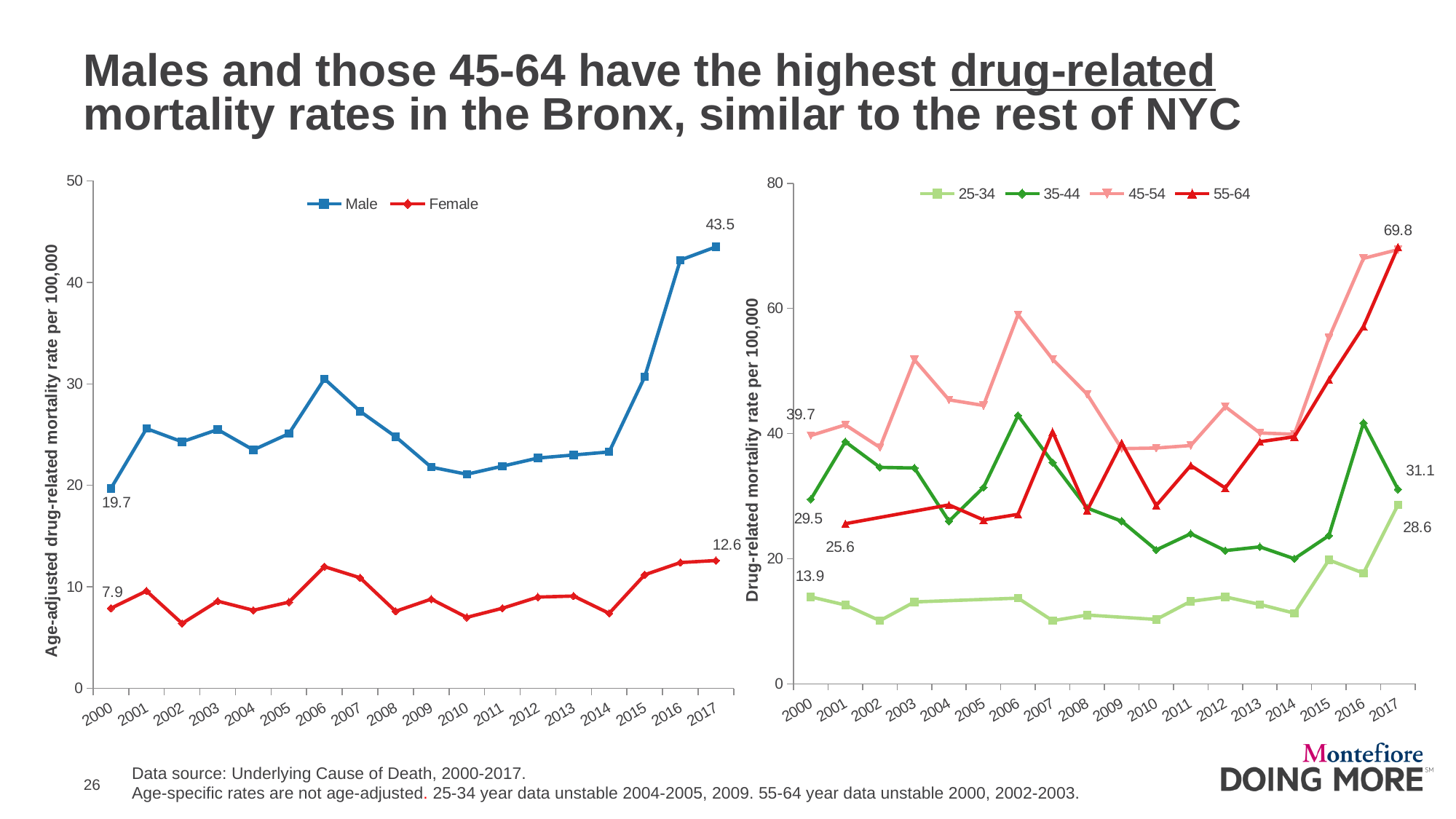
In the left chart, which series has the higher value in 2017, Male or Female? Male In the left chart, what is the Female rate in 2000? 7.9 In the left chart, is the Male value for 2010 greater or less than 30? less In the right chart, what is the drug-related mortality rate for the 55-64 age group in 2017? 69.8 How many age groups does the legend of the right chart list? 4 In the left chart, what is the Male age-adjusted drug-related mortality rate in 2017? 43.5 How many series does the legend of the left chart list? 2 In the left chart, by how much did the Male rate increase from 2000 to 2017? 23.8 In the right chart, what is the rate for the 25-34 age group in 2000? 13.9 In the right chart, what is the difference between the 35-44 and 25-34 rates in 2017? 2.5 What type of chart is the left chart? Line chart In the right chart, is the value for the 45-54 age group in 2006 greater or less than 40? greater